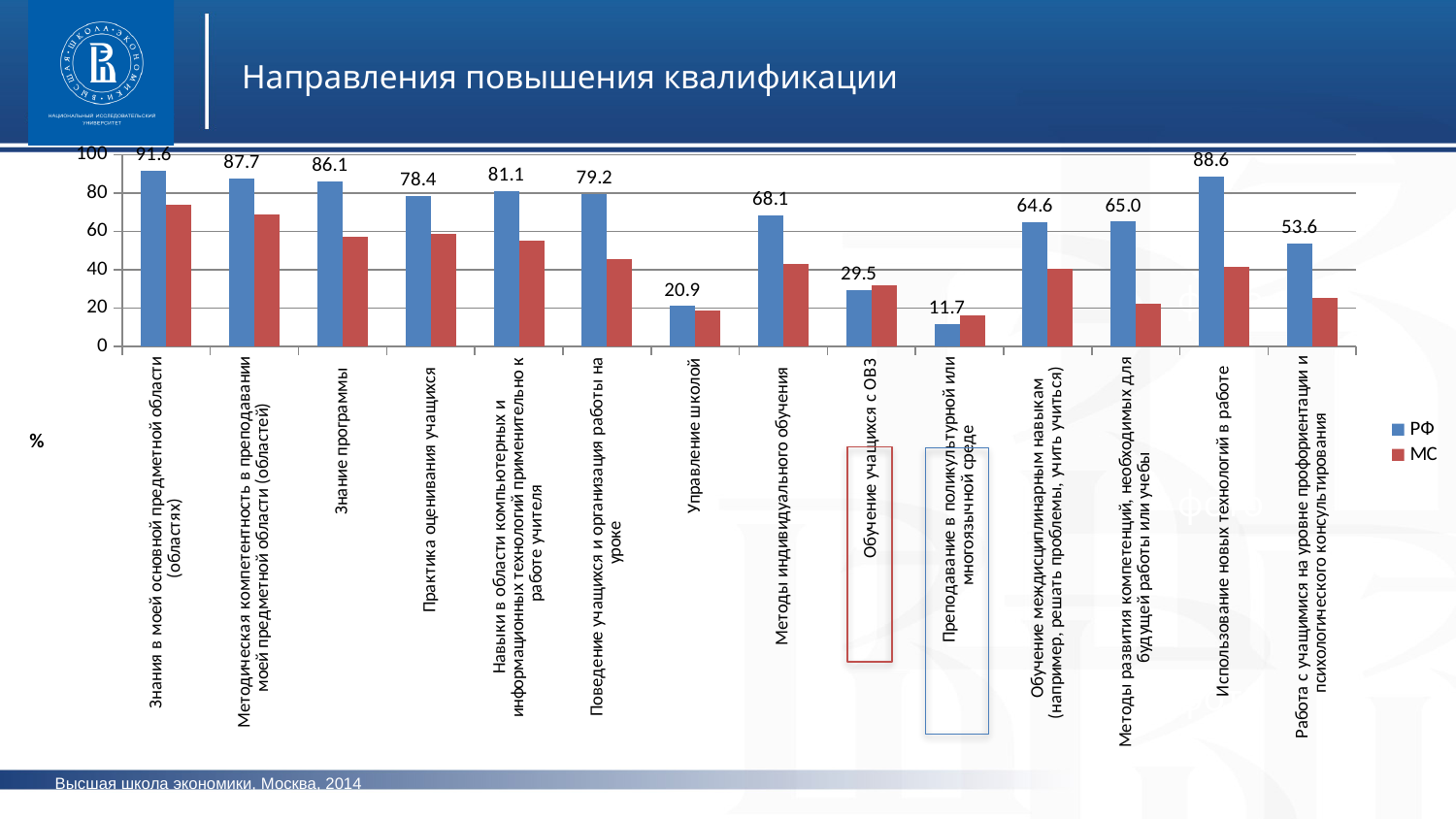
What is the РФ value for "Управление школой"? 20.9 Is the МС value for "Знания в моей основной предметной области (областях)" greater or less than 60? greater How many series does the legend list? 2 Which category has the lowest РФ value? Преподавание в поликультурной или многоязычной среде For "Знание программы", which series has the larger value, РФ or МС? РФ Which category has the highest РФ value? Знания в моей основной предметной области (областях) What is the РФ value for "Знание программы"? 86.1 How many categories are shown on the x axis? 14 What kind of chart is shown on the slide? bar chart Is the МС value for "Использование новых технологий в работе" greater or less than 60? less What is the РФ value for "Использование новых технологий в работе"? 88.6 What is the difference between the РФ values for "Знание программы" and "Практика оценивания учащихся"? 7.7